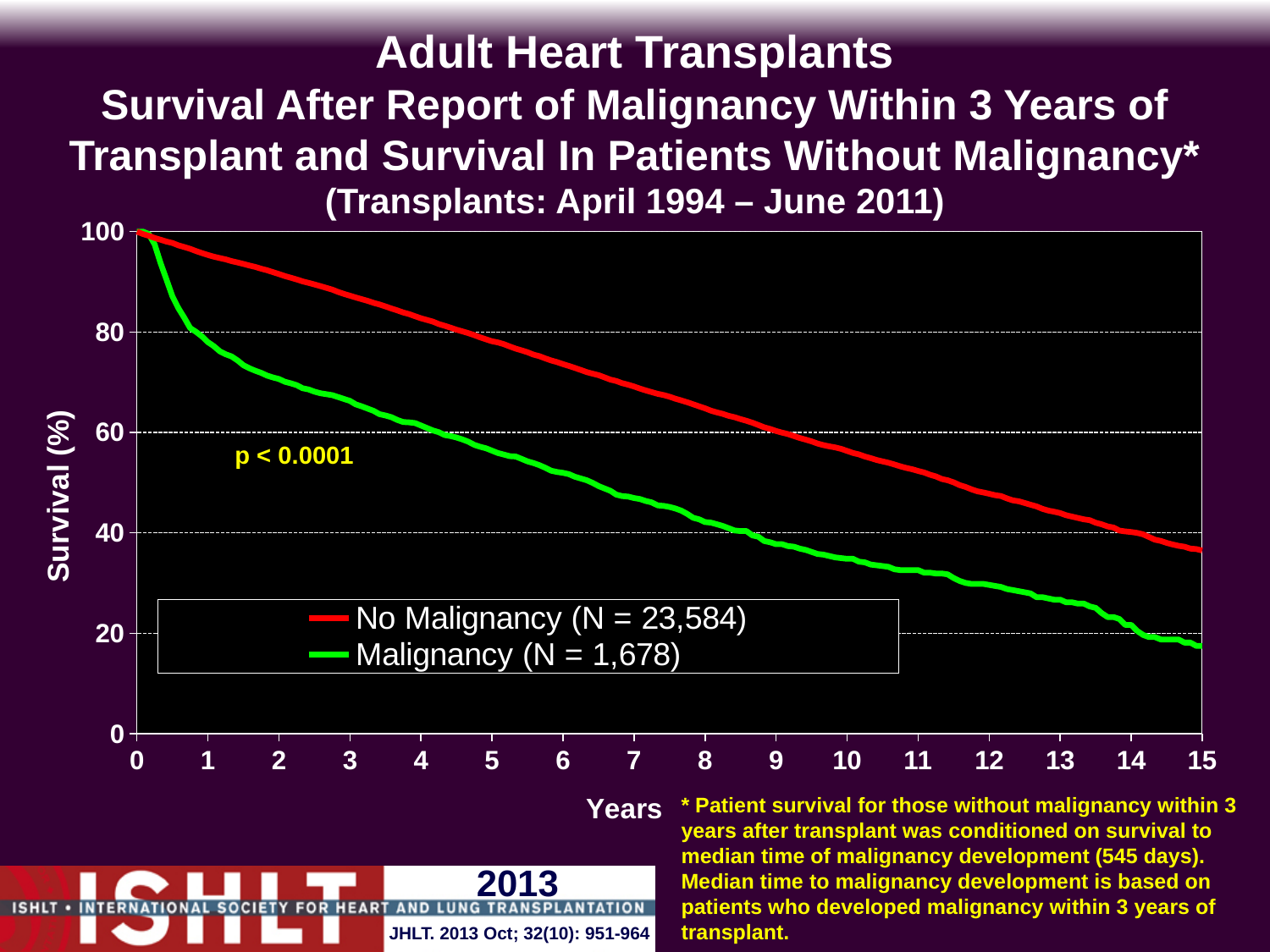
What kind of chart is shown on the slide? line chart How many series does the legend list? 2 What p-value is printed on the chart? p < 0.0001 What is the survival value for the No Malignancy series at year 0? 100 Is the survival value for the No Malignancy series at year 5 greater or less than 60? greater Is the survival value for the No Malignancy series at year 10 greater or less than 40? greater Is the survival value for the Malignancy series at year 10 greater or less than 40? less At year 8, which series has the higher survival, No Malignancy or Malignancy? No Malignancy Do the survival values for the Malignancy series rise or fall as years increase? fall What is the N for the Malignancy series shown in the legend? 1,678